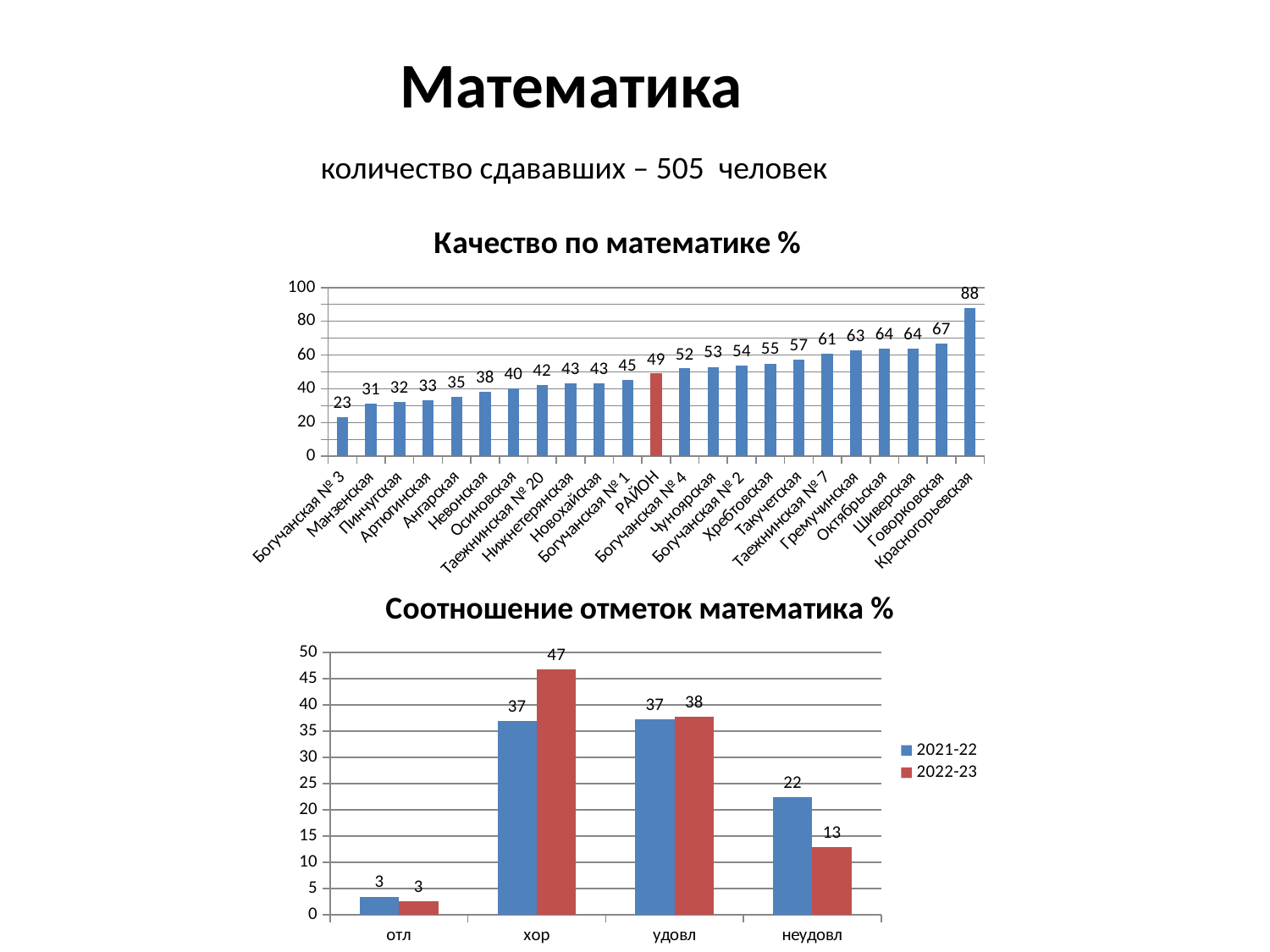
In the chart 'Соотношение отметок математика %', how many series does the legend list? 2 In the chart 'Качество по математике %', which category has the lowest value? Богучанская № 3 In the chart 'Качество по математике %', what is the difference between Красногорьевская and Говорковская? 21 What kind of chart is 'Соотношение отметок математика %'? Bar chart In the chart 'Соотношение отметок математика %', what is the difference between 2021-22 and 2022-23 for неудовл? 9 In the chart 'Качество по математике %', what is the value for Говорковская? 67 In the chart 'Качество по математике %', which category has the highest value? Красногорьевская In the chart 'Качество по математике %', which is larger: Чуноярская or Невонская? Чуноярская In the chart 'Соотношение отметок математика %', what is the value for неудовл in 2021-22? 22 In the chart 'Качество по математике %', what is the value for РАЙОН? 49 In the chart 'Качество по математике %', how many categories are shown? 23 In the chart 'Соотношение отметок математика %', what is the value for хор in 2022-23? 47